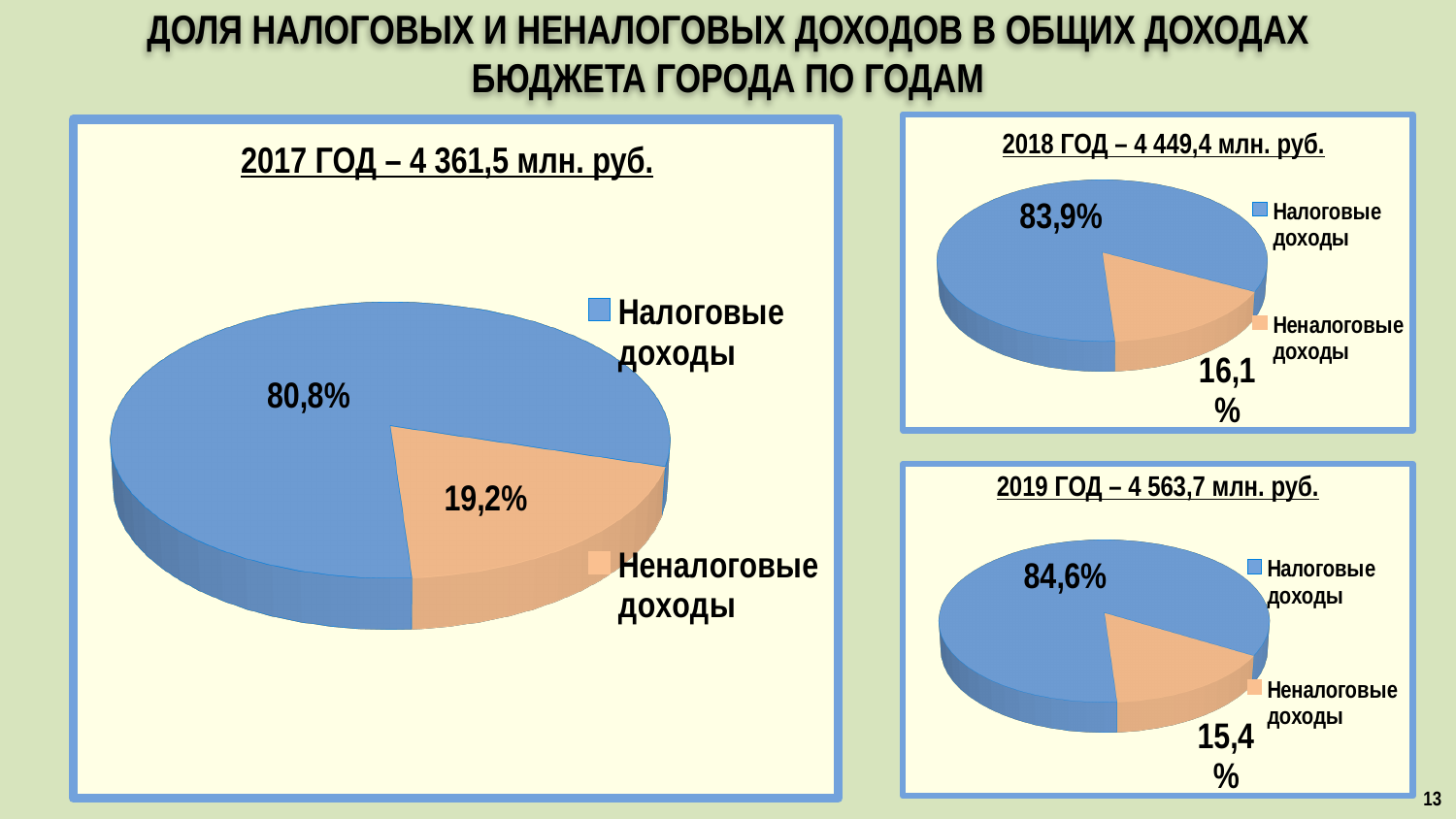
In the 2018 chart, what is the difference between the shares of Налоговые доходы and Неналоговые доходы? 67,8 percentage points In the 2019 chart, what share do Неналоговые доходы have? 15,4% In the 2019 chart (2019 ГОД – 4 563,7 млн. руб.), what share do Налоговые доходы have? 84,6% In the 2017 chart, what share do Неналоговые доходы have? 19,2% How many categories does the legend of the 2018 chart list? 2 In the 2019 chart, which category has the smallest slice? Неналоговые доходы What type of chart is used on this slide for each year? Pie chart Which is larger: the share of Неналоговые доходы in the 2017 chart or in the 2019 chart? 2017 chart In the 2017 chart, which category has the largest slice? Налоговые доходы In the 2018 chart (2018 ГОД – 4 449,4 млн. руб.), what share do Налоговые доходы have? 83,9% In the 2017 chart (2017 ГОД – 4 361,5 млн. руб.), what share do Налоговые доходы have? 80,8% In the 2018 chart, what share do Неналоговые доходы have? 16,1%